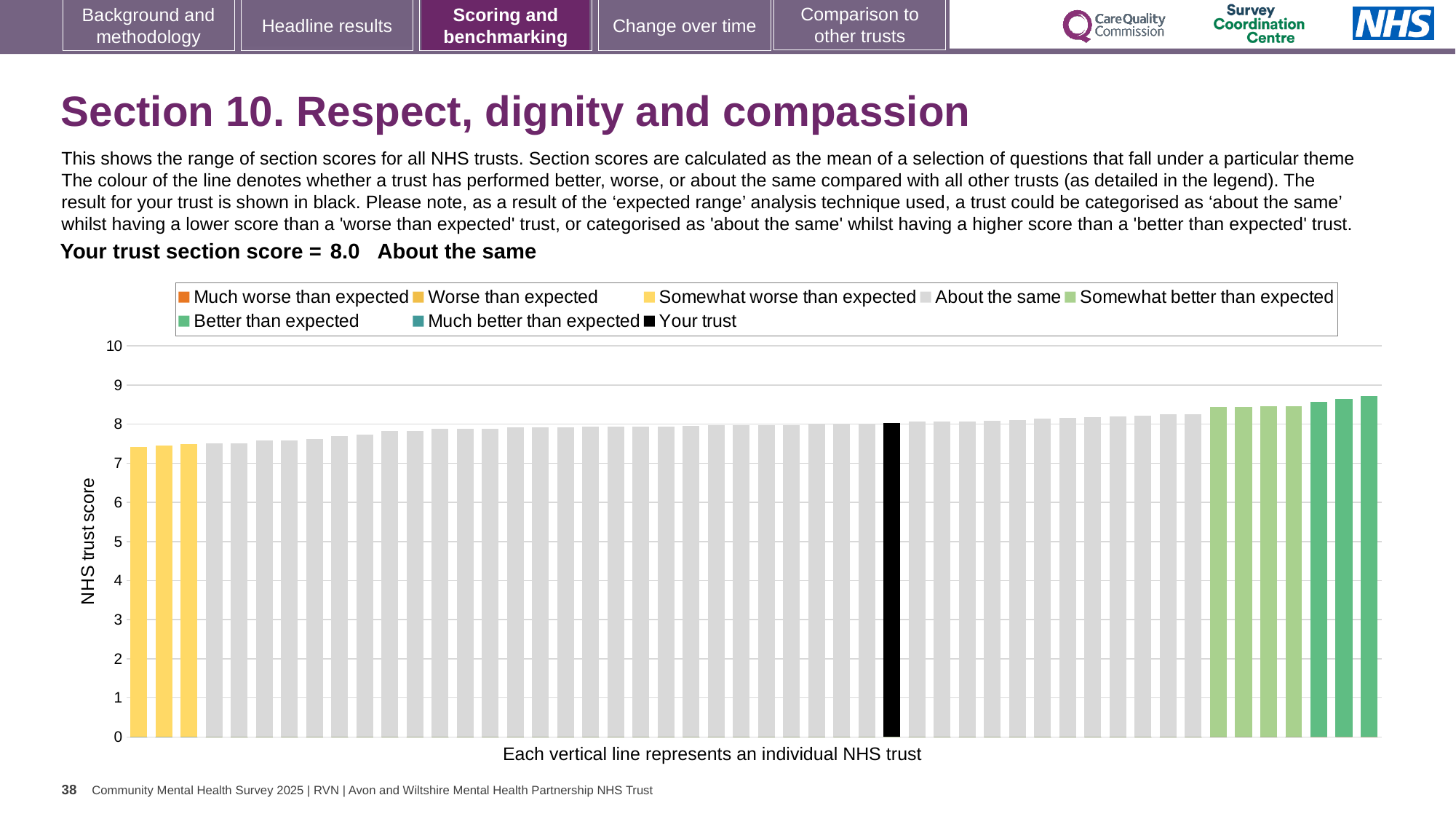
Which is larger: the rightmost green bar or the black 'Your trust' bar? the rightmost green bar What is the section score for your trust (the black bar)? 8.0 What kind of chart is shown on the slide? bar chart Do the bar values rise or fall from left to right across the chart? rise What is the label on the vertical axis of the chart? NHS trust score How many entries does the chart legend list? 8 Is the value of the black 'Your trust' bar greater or less than 9? less How many yellow bars (trusts categorised as worse than expected) are shown at the left of the chart? 3 Is the value of the leftmost (lowest) bar greater or less than 7? greater Is the value of the black 'Your trust' bar greater or less than 7? greater What does the text below the horizontal axis say each vertical line represents? an individual NHS trust